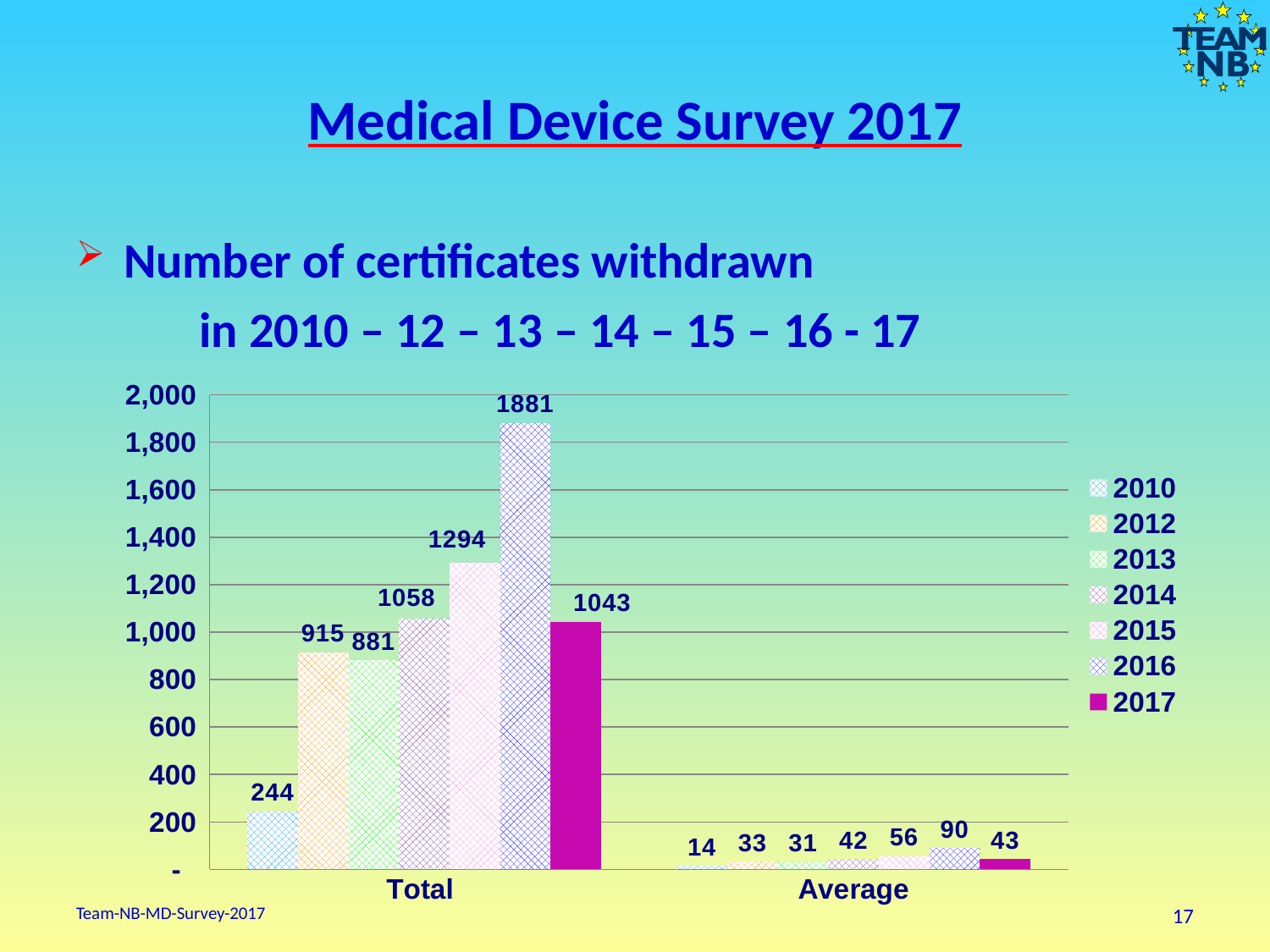
Is the Total value for 2015 greater or less than 1,200? greater What is the difference between the Total values for 2016 and 2017? 838 What is the Total number of certificates withdrawn in 2016? 1881 Which year has the lowest Average value? 2010 How many series does the legend list? 7 What kind of chart is shown on the slide? bar chart What is the Average value for 2017? 43 Which series is shown as a solid magenta bar in the legend? 2017 Which is larger, the Total value for 2012 or for 2013? 2012 What is the Total value for 2010? 244 How many categories are shown on the x axis? 2 Which year has the highest Total number of certificates withdrawn? 2016